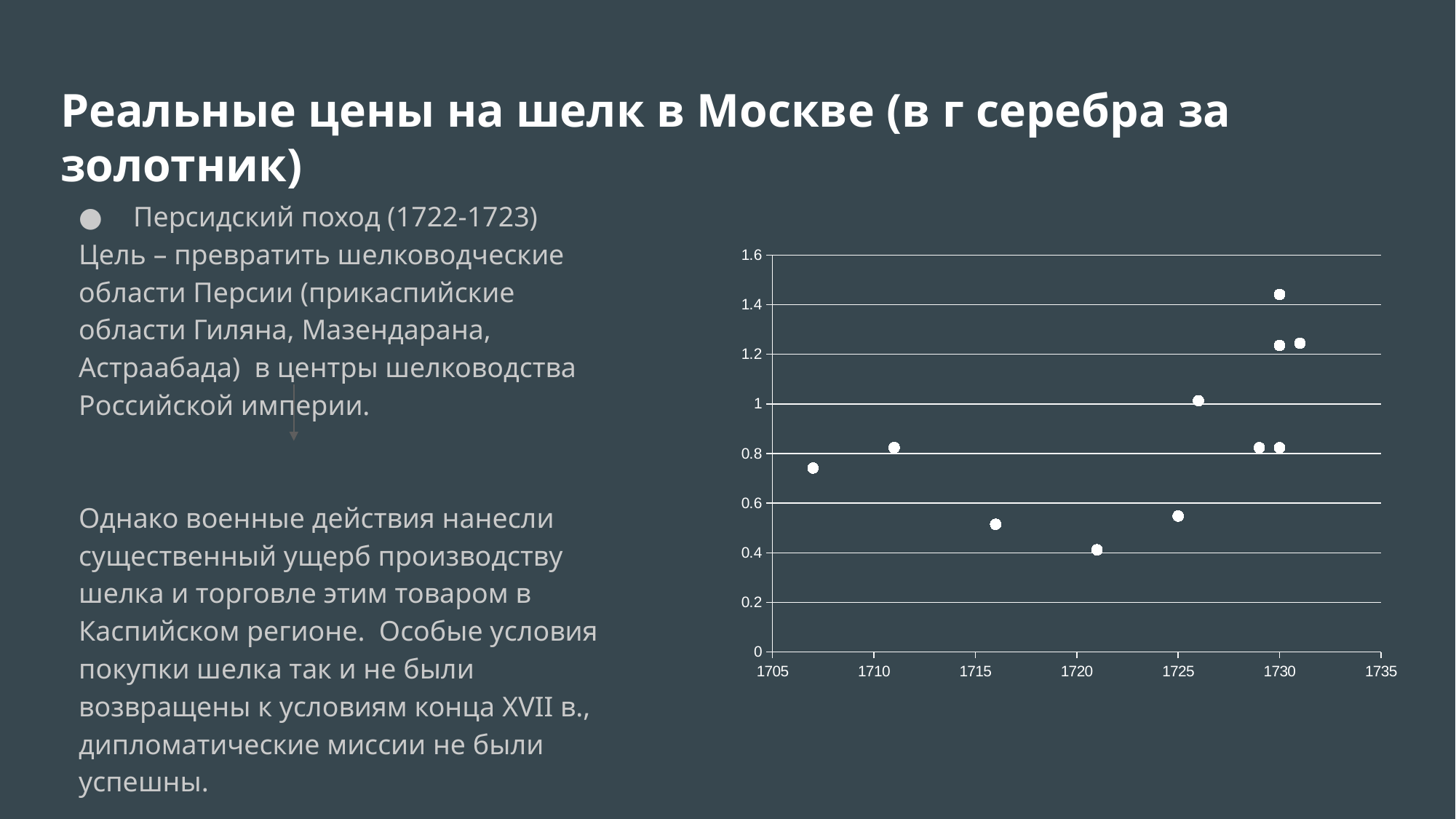
Do the plotted values generally rise or fall between 1721 and 1731? rise How many data points are plotted on the chart? 11 Which is larger: the value of the point at about 1716 or the point at about 1726? the point at about 1726 Is the value of the point plotted at about 1721 greater or less than 0.6? less What is the maximum value shown on the vertical axis? 1.6 Around which year on the x axis is the lowest plotted point located? 1721 Around which year on the x axis is the highest plotted point located? 1730 Is the value of the point plotted at about 1707 greater or less than 1? less Is the value of the point plotted at about 1726 greater or less than 0.8? greater What kind of chart is shown on the slide? scatter chart What is the title of the slide containing the chart? Реальные цены на шелк в Москве (в г серебра за золотник)